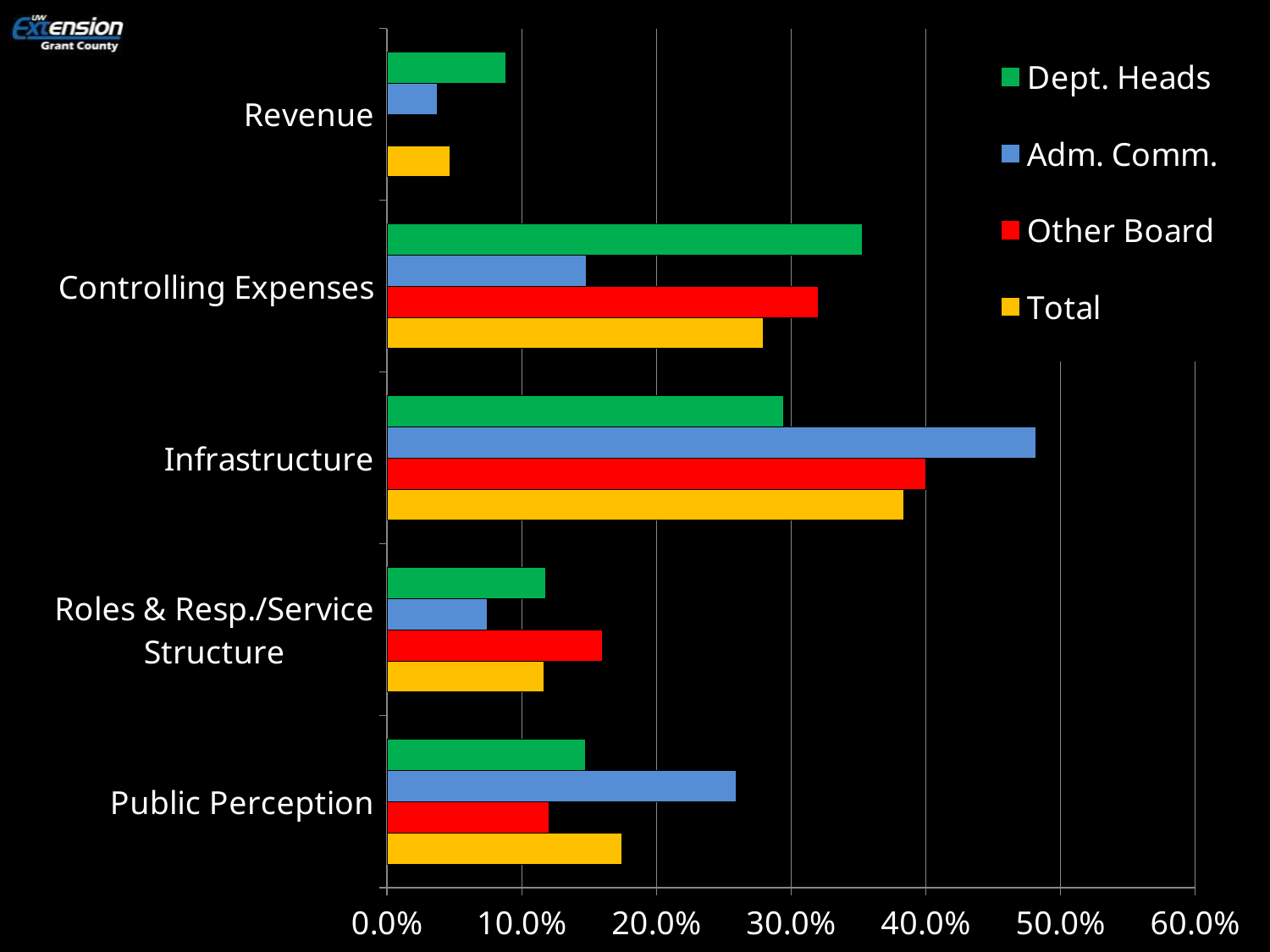
Is the Adm. Comm. value for Public Perception greater or less than 20.0%? greater Is the Adm. Comm. value for Infrastructure greater or less than 40.0%? greater How many categories are shown on the vertical axis of the chart? 5 Is the Total value for Controlling Expenses greater or less than 30.0%? less How many series does the legend list? 4 Which category has the highest Adm. Comm. value? Infrastructure For Public Perception, which is larger: the Adm. Comm. value or the Other Board value? Adm. Comm. What kind of chart is shown on the slide? Bar chart Which category has the lowest Total value? Revenue What colour represents the Total series in the legend? Yellow For Roles & Resp./Service Structure, which series has the highest value? Other Board For Controlling Expenses, which is larger: the Dept. Heads value or the Adm. Comm. value? Dept. Heads